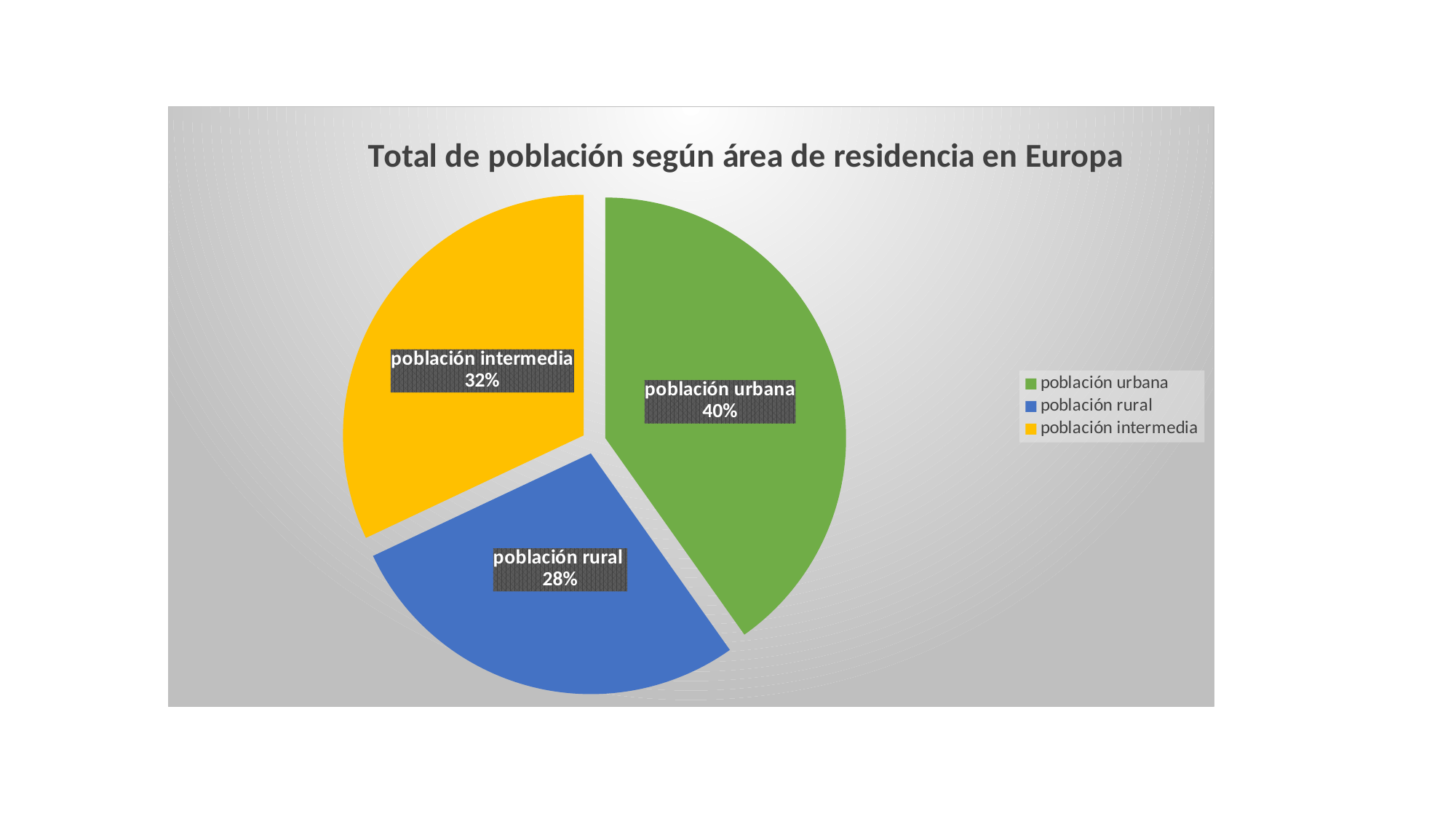
How many categories are shown in the pie chart? 3 What is the difference in percentage points between población urbana and población rural? 12 Which category has the smallest share of the pie? población rural What share of the pie does población rural represent? 28% What share of the pie does población intermedia represent? 32% What colour is the población rural slice? blue Which category has the largest share of the pie? población urbana What is the title of the chart? Total de población según área de residencia en Europa What is the difference in percentage points between población intermedia and población rural? 4 Which is larger, población intermedia or población rural? población intermedia What kind of chart is shown on the slide? pie chart What share of the pie does población urbana represent? 40%